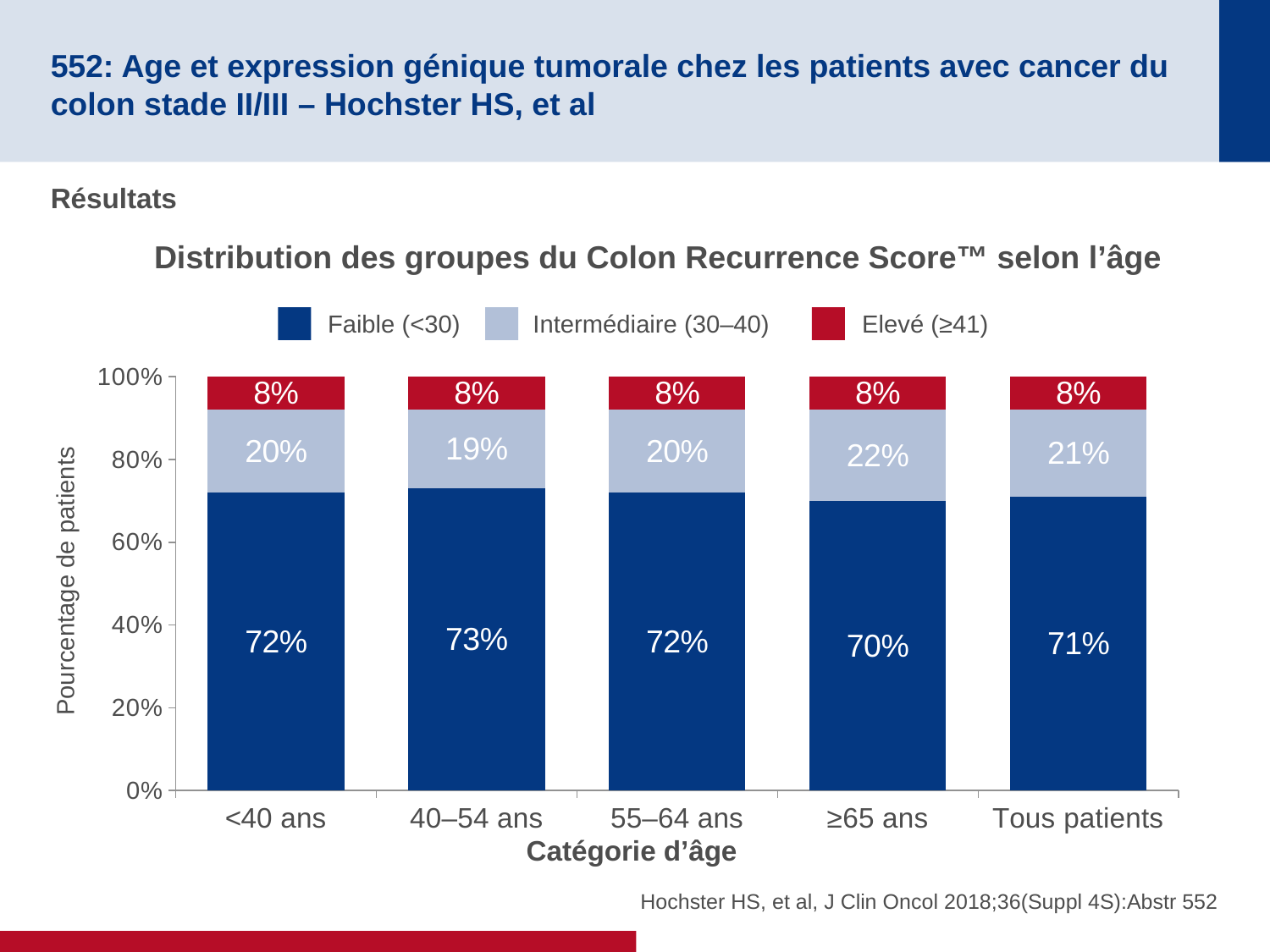
Which is larger: the Intermédiaire (30–40) value for ≥65 ans or for 40–54 ans? ≥65 ans What is the title of the chart? Distribution des groupes du Colon Recurrence Score™ selon l'âge What is the value for Faible (<30) in the Tous patients category? 71% What kind of chart is shown on the slide? Stacked bar chart What is the difference between the Faible (<30) values for 40–54 ans and ≥65 ans? 3% What is the value for Elevé (≥41) in the Tous patients category? 8% How many series does the legend list? 3 How many age categories are shown on the x axis? 5 Which age category has the lowest value for Faible (<30)? ≥65 ans What is the value for Faible (<30) in the 40–54 ans category? 73% What is the value for Intermédiaire (30–40) in the ≥65 ans category? 22% Which age category has the highest value for Faible (<30)? 40–54 ans